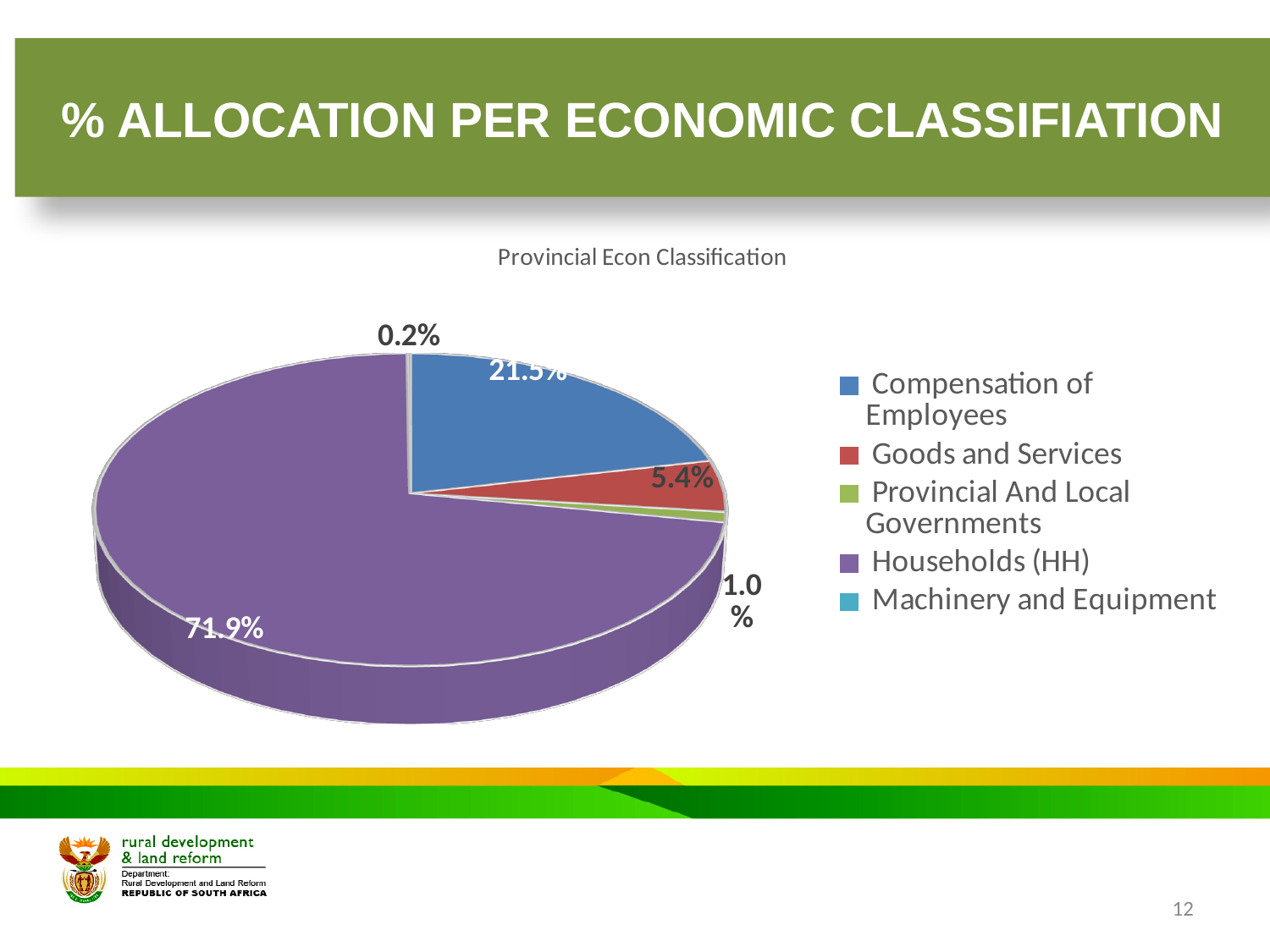
What is the title of the chart? Provincial Econ Classification What percentage is shown for Machinery and Equipment? 0.2% What percentage is shown for Goods and Services? 5.4% What percentage is shown for Provincial And Local Governments? 1.0% Which is larger, the share for Goods and Services or the share for Provincial And Local Governments? Goods and Services How many categories does the legend list? 5 What is the difference between the shares of Households (HH) and Compensation of Employees? 50.4% What percentage is shown for Households (HH)? 71.9% Which category has the smallest share of the pie? Machinery and Equipment Which category has the largest share of the pie? Households (HH) What percentage is shown for Compensation of Employees? 21.5% What kind of chart is shown on the slide? pie chart